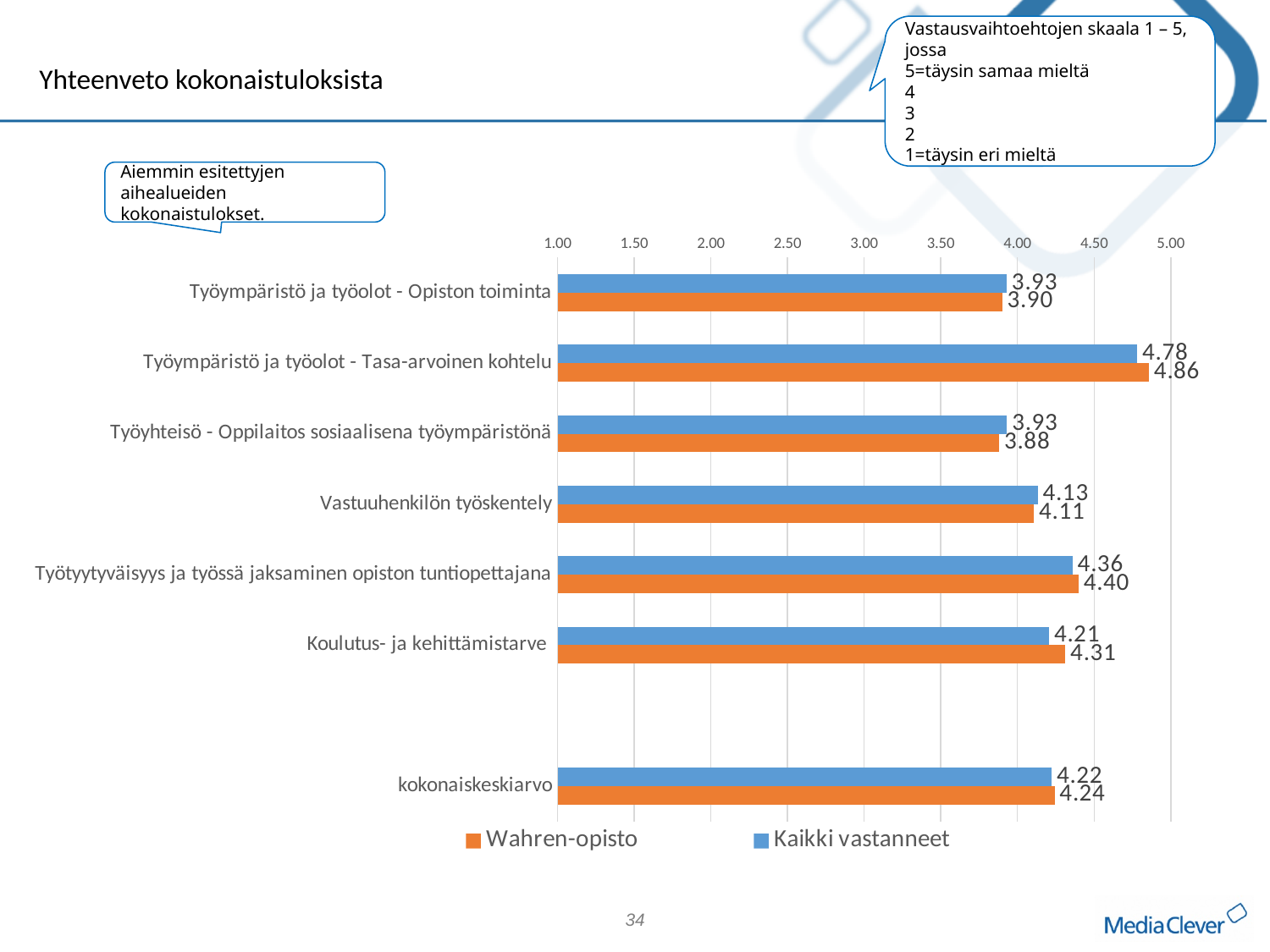
Which category has the lowest value for Wahren-opisto? Työyhteisö - Oppilaitos sosiaalisena työympäristönä What is the value for Wahren-opisto in the category 'Työympäristö ja työolot - Tasa-arvoinen kohtelu'? 4.86 How many labelled categories are shown on the chart? 7 How many series does the legend list? 2 What is the value for Kaikki vastanneet in the category 'Koulutus- ja kehittämistarve'? 4.21 For 'Työtyytyväisyys ja työssä jaksaminen opiston tuntiopettajana', which series has the larger value, Wahren-opisto or Kaikki vastanneet? Wahren-opisto What is the value for Wahren-opisto in the category 'kokonaiskeskiarvo'? 4.24 Which category has the highest value for Wahren-opisto? Työympäristö ja työolot - Tasa-arvoinen kohtelu Which colour represents the Kaikki vastanneet series? blue Is the Kaikki vastanneet value for 'Vastuuhenkilön työskentely' greater or less than 4.00? greater What kind of chart is shown on the slide? bar chart What is the difference between the Wahren-opisto and Kaikki vastanneet values for 'Koulutus- ja kehittämistarve'? 0.10